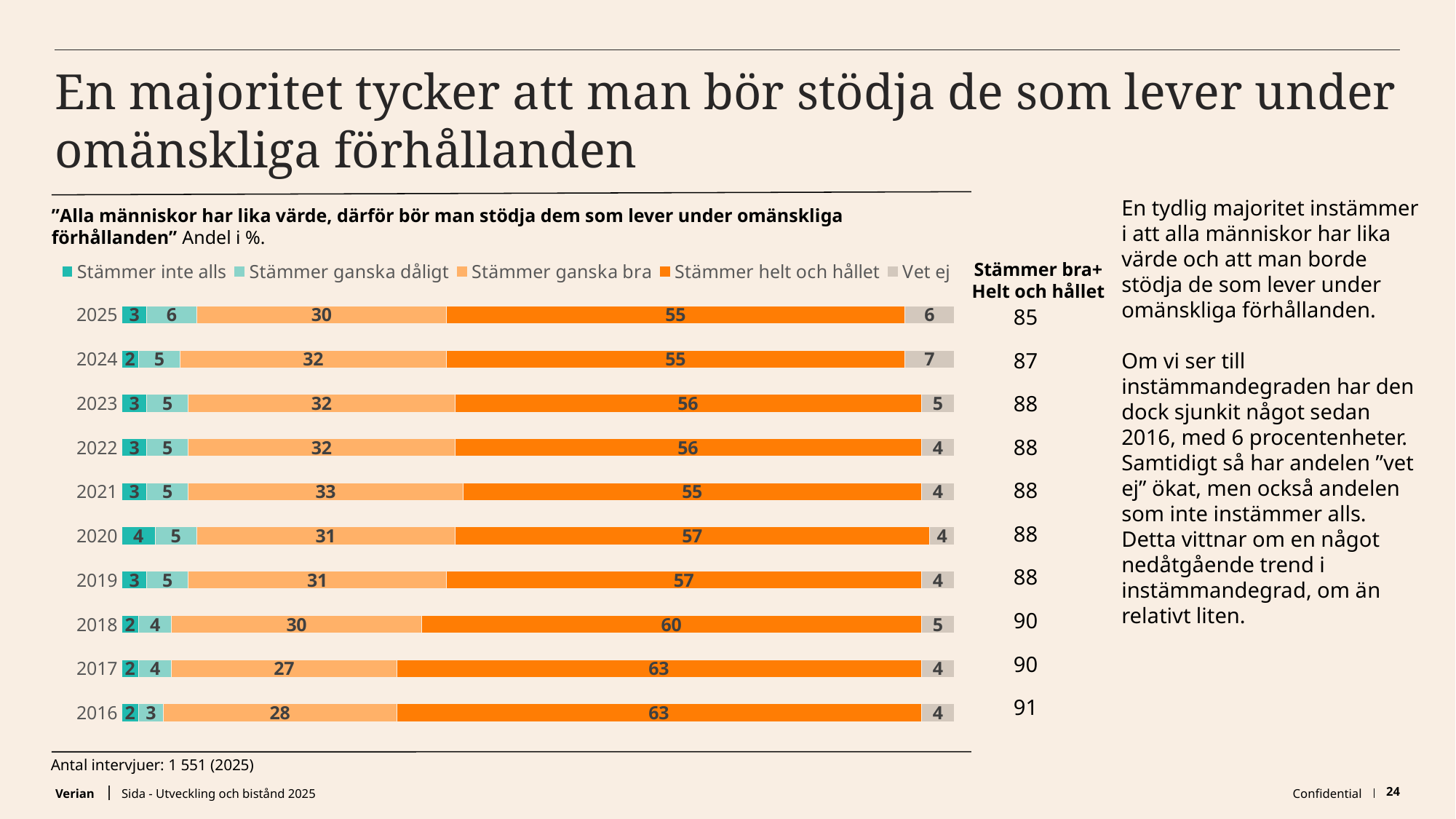
What is the value for "Stämmer ganska bra" in 2017? 27 What kind of chart is shown on the slide? Stacked bar chart What is the total of the stacked bar for 2025? 100 How many years are shown in the chart? 10 What is the value for "Stämmer helt och hållet" in 2025? 55 Does the "Stämmer helt och hållet" value generally rise or fall from 2016 to 2025? Fall What is the value for "Vet ej" in 2024? 7 How many series does the legend list? 5 What is the difference between the "Stämmer helt och hållet" value in 2016 and in 2025? 8 Which year has the larger "Stämmer helt och hållet" value, 2018 or 2025? 2018 In which year is the "Stämmer ganska bra" value lowest? 2017 In which year is the "Stämmer ganska bra" value highest? 2021